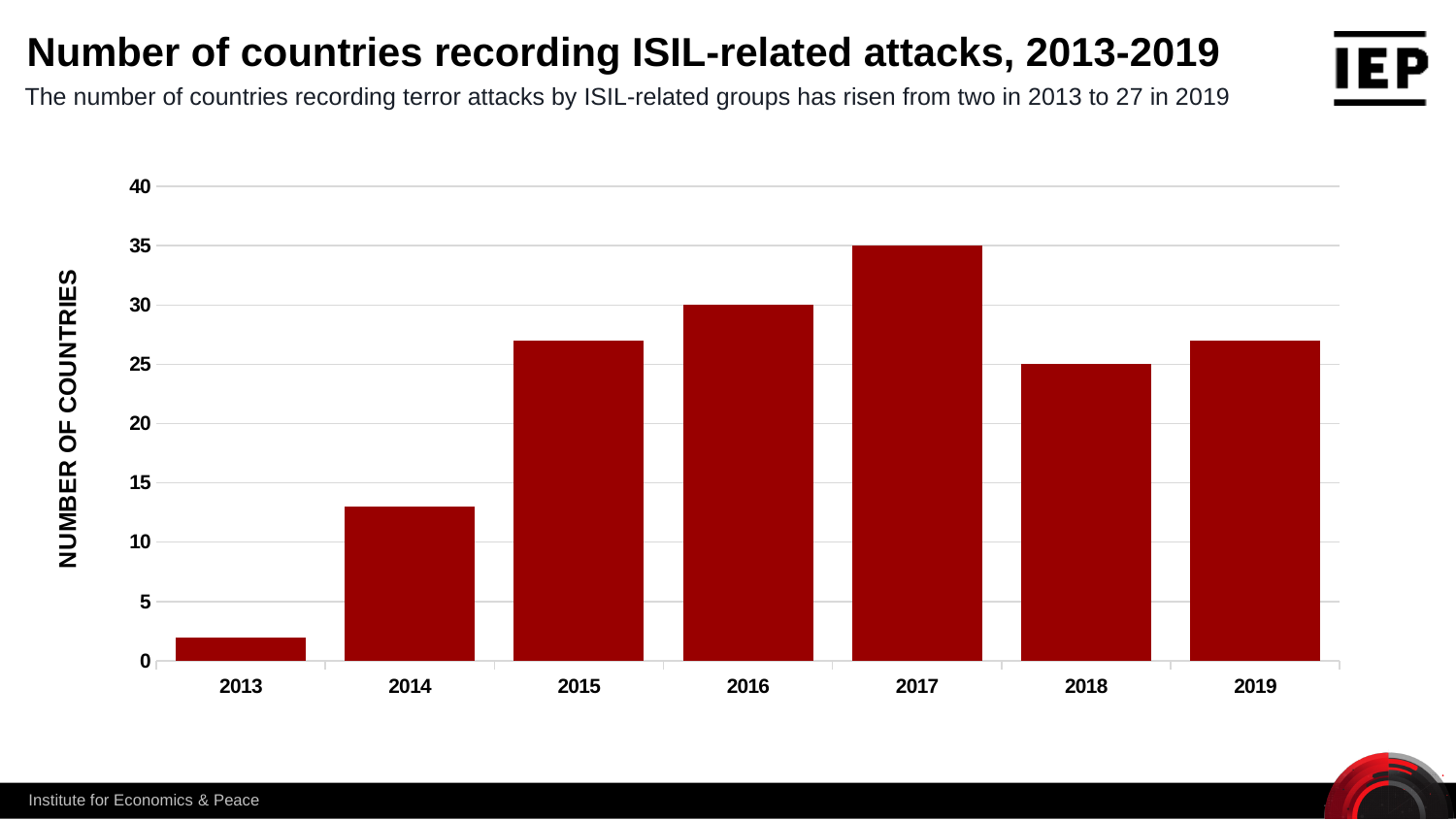
What is the title of the y axis? NUMBER OF COUNTRIES Is the value for 2014 greater or less than 15? less What is the value for 2018? 25 What is the value for 2017? 35 What is the difference between the values for 2017 and 2018? 10 Which year has the highest number of countries? 2017 What kind of chart is this? bar chart What is the value for 2016? 30 How many countries recorded ISIL-related attacks in 2019? 27 Which is larger, the value for 2016 or the value for 2018? 2016 How many years are shown on the x axis? 7 Which year has the lowest number of countries? 2013